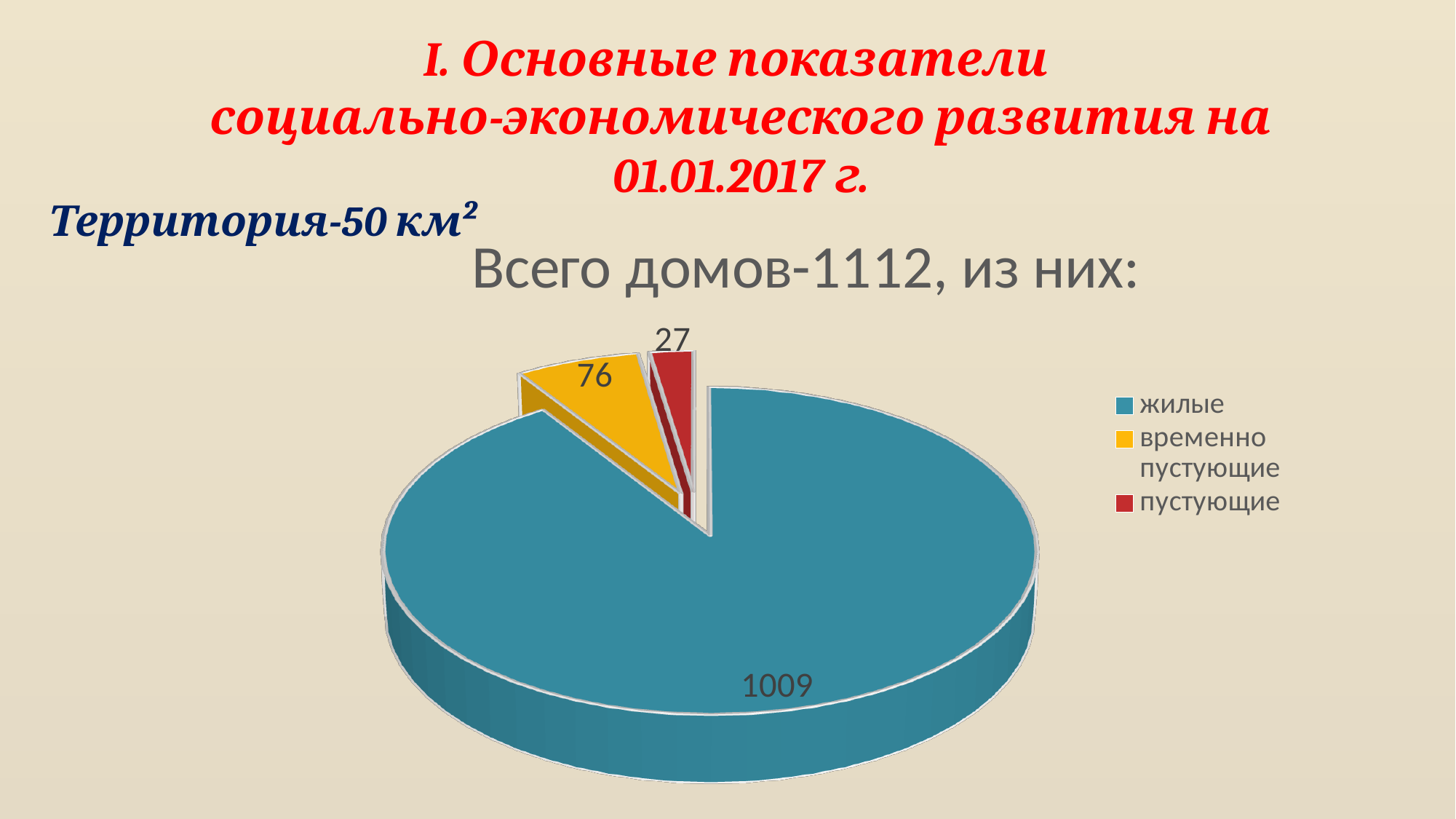
What is the value for жилые? 1009 What is the difference between the values for временно пустующие and пустующие? 49 Which category has the smallest slice? пустующие How many slices does the pie chart have? 3 What kind of chart is shown on the slide? pie chart What is the title of the chart? Всего домов-1112, из них: Which is larger, временно пустующие or пустующие? временно пустующие How many entries does the legend list? 3 What is the value for пустующие? 27 What is the value for временно пустующие? 76 Which category has the largest slice? жилые What colour is the slice for пустующие? red